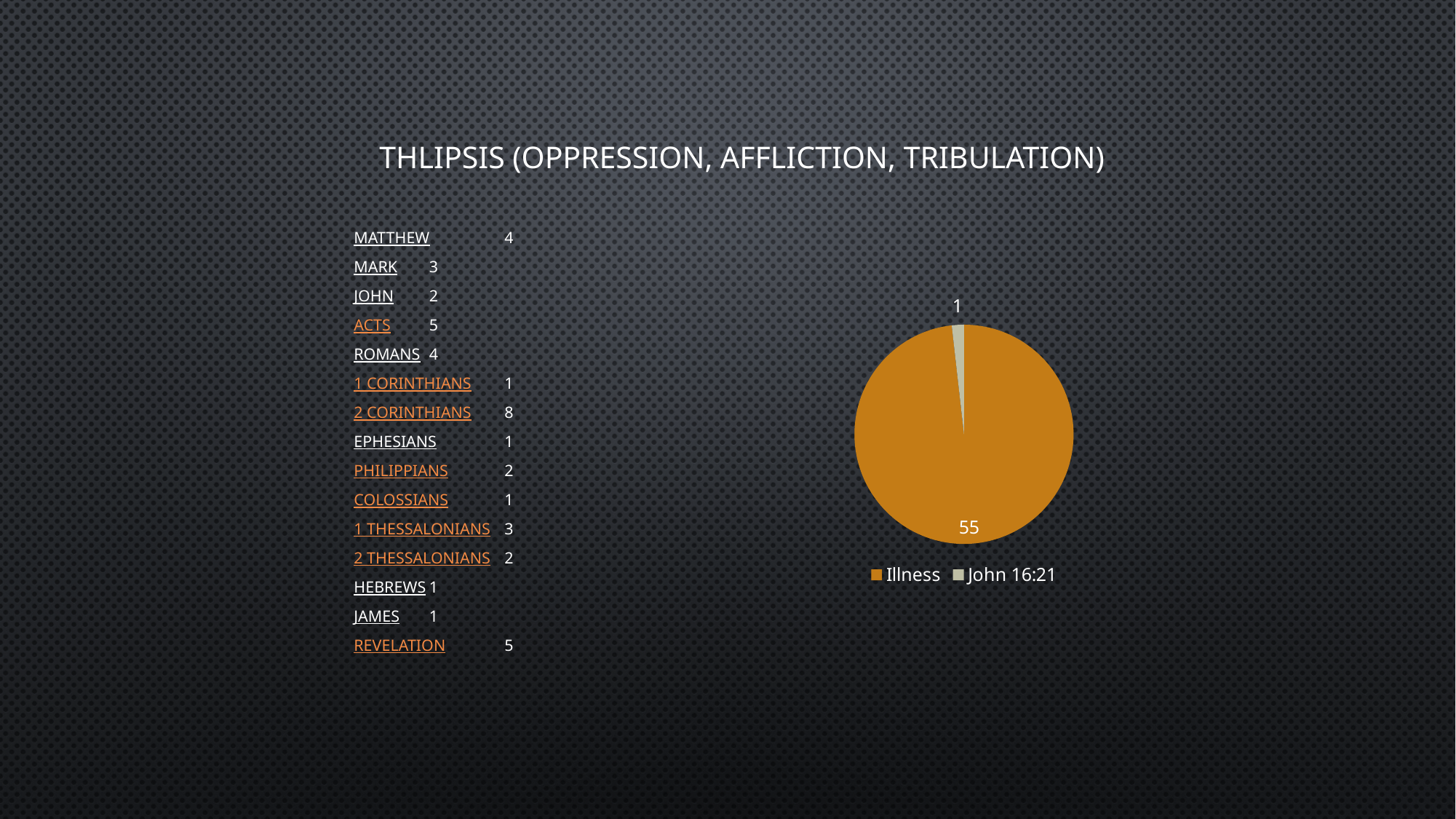
Which is larger in the pie chart, Illness or John 16:21? Illness What is the difference between the Illness value and the John 16:21 value in the pie chart? 54 How many slices does the pie chart have? 2 What colour is the Illness slice in the pie chart? orange What is the value of the John 16:21 slice in the pie chart? 1 What are the two legend entries of the pie chart? Illness and John 16:21 What kind of chart is shown on the slide? pie chart Which slice of the pie chart is the largest? Illness What is the value of the Illness slice in the pie chart? 55 How many entries does the pie chart's legend list? 2 What is the total of the two values shown in the pie chart? 56 Which slice of the pie chart is the smallest? John 16:21